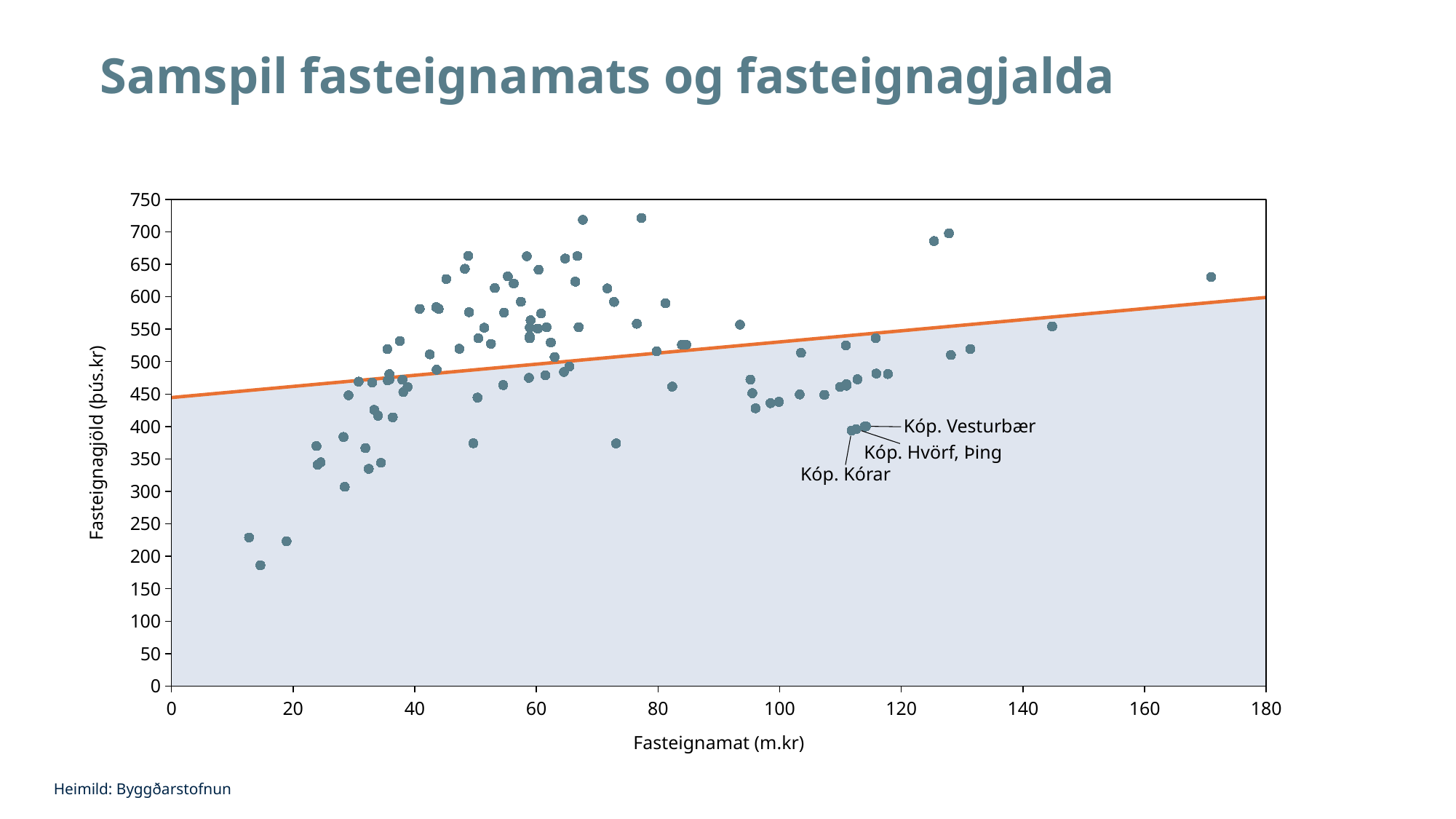
What is the highest tick value shown on the x axis of the chart? 180 What kind of chart is shown on the slide? Scatter chart What is the title of the chart on the slide? Samspil fasteignamats og fasteignagjalda Is the highest Fasteignagjöld value plotted on the chart greater or less than 700? greater Does the orange trend line rise or fall as Fasteignamat increases along the x axis? Rises What is the label of the x axis of the chart? Fasteignamat (m.kr) Is the Fasteignamat value for Kóp. Vesturbær greater or less than 100? greater Is the value of the orange trend line at Fasteignamat 100 greater or less than 500? greater How many points on the chart are labelled with a name? 3